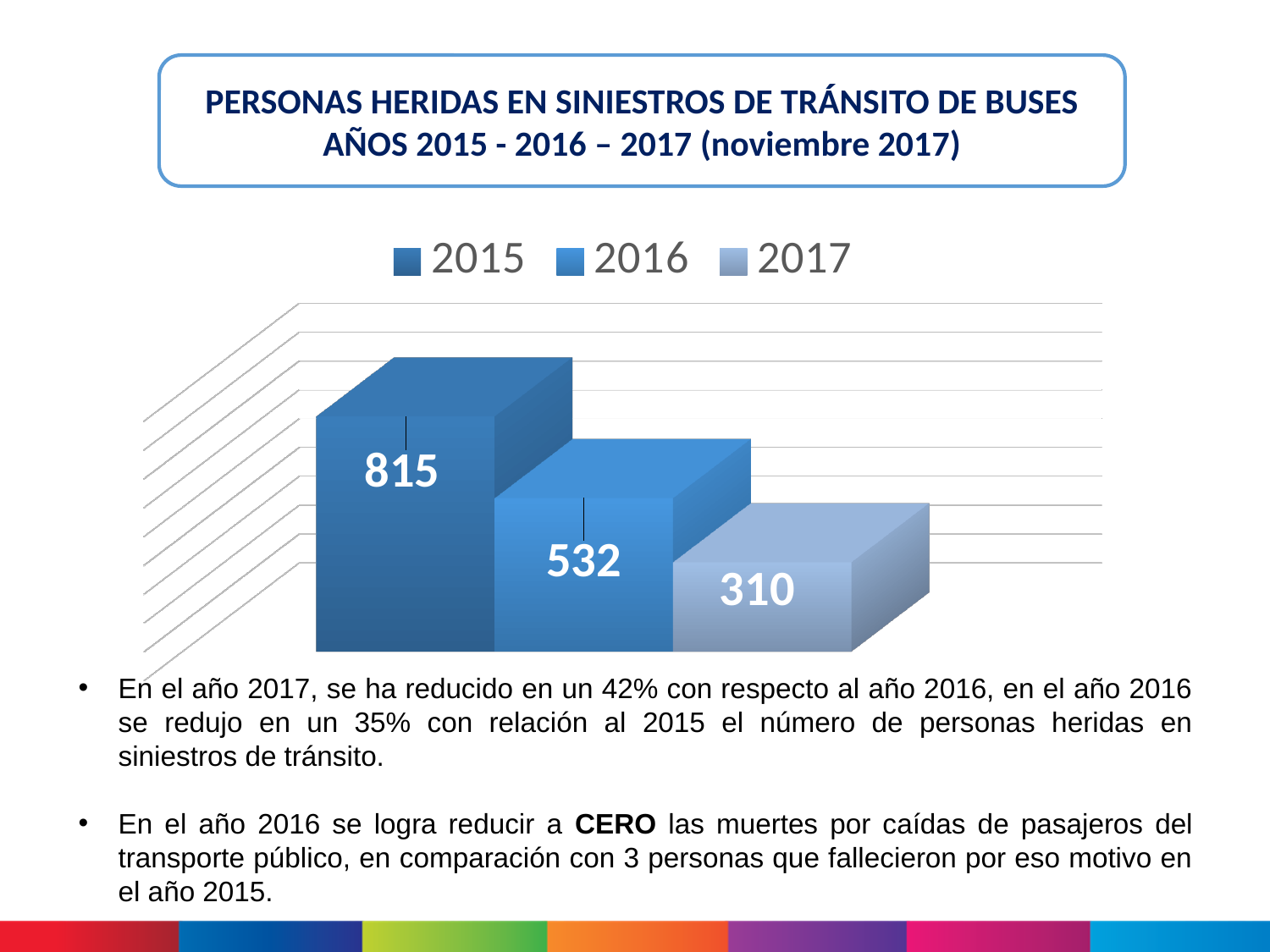
What kind of chart is shown on the slide? Bar chart Which is larger, the value for 2016 or the value for 2017? 2016 What is the number of injured persons shown for 2016? 532 What is the difference between the values for 2015 and 2016? 283 What is the total of the three values shown in the chart? 1657 What is the number of injured persons shown for 2015? 815 Do the values rise or fall from 2015 to 2017? Fall Which year has the highest number of injured persons? 2015 What is the difference between the values for 2016 and 2017? 222 How many series does the legend list? 3 What is the number of injured persons shown for 2017? 310 Which year has the lowest number of injured persons? 2017